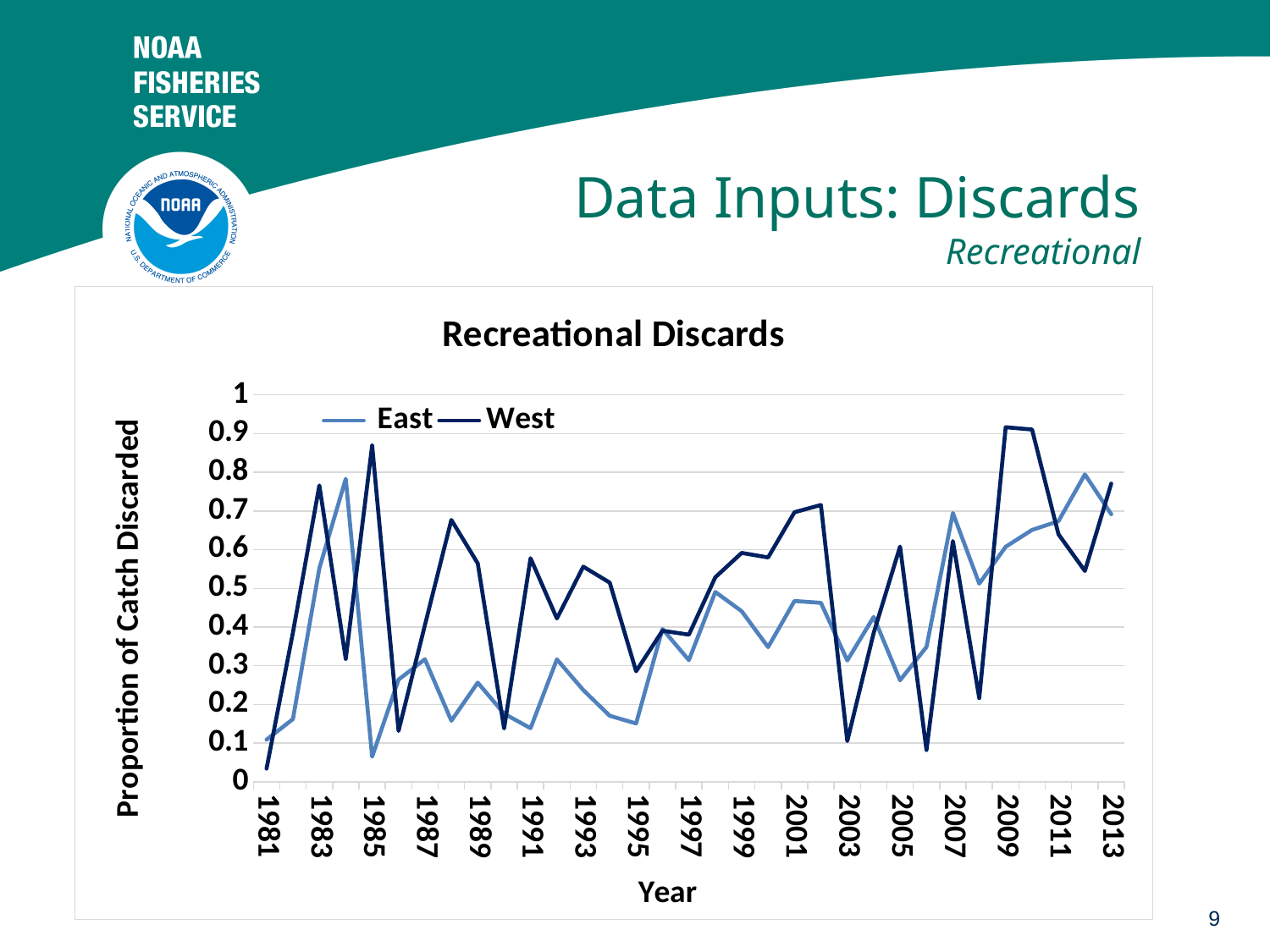
In 1984, which series has the larger value, East or West? East Is the East value for 1984 greater or less than 0.7? greater What is the label of the y axis? Proportion of Catch Discarded In 1985, which series has the larger value, East or West? West Is the West value for 1981 greater or less than 0.1? less Is the West value for 1985 greater or less than 0.8? greater What kind of chart is shown on the slide? line chart Does the West series rise or fall from 1981 to 1983? rise What is the title of the chart? Recreational Discards How many series does the legend list? 2